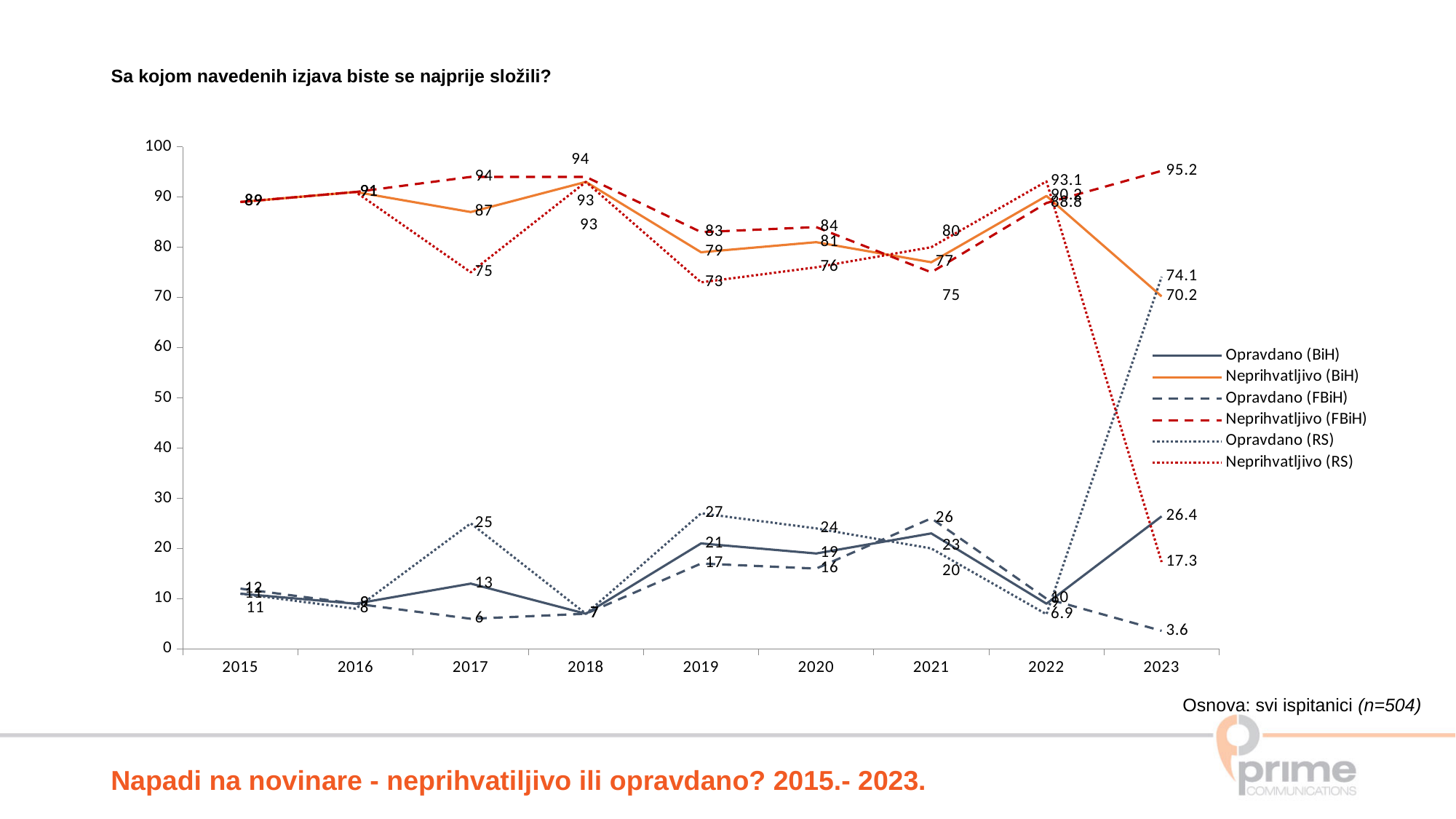
Which series has the highest value in 2023? Neprihvatljivo (FBiH) Is the value for Neprihvatljivo (BiH) in 2023 greater or less than 80? less What is the value for Opravdano (FBiH) in 2023? 3.6 What kind of chart is shown on the slide? line chart What is the value for Neprihvatljivo (RS) in 2023? 17.3 How many years are shown on the x axis? 9 How many series does the legend list? 6 What is the value for Neprihvatljivo (FBiH) in 2023? 95.2 Which series has the lowest value in 2023? Opravdano (FBiH) What is the value for Opravdano (RS) in 2017? 25 What is the difference between Neprihvatljivo (FBiH) and Opravdano (FBiH) in 2023? 91.6 In 2023, which is larger: Opravdano (RS) or Neprihvatljivo (RS)? Opravdano (RS)